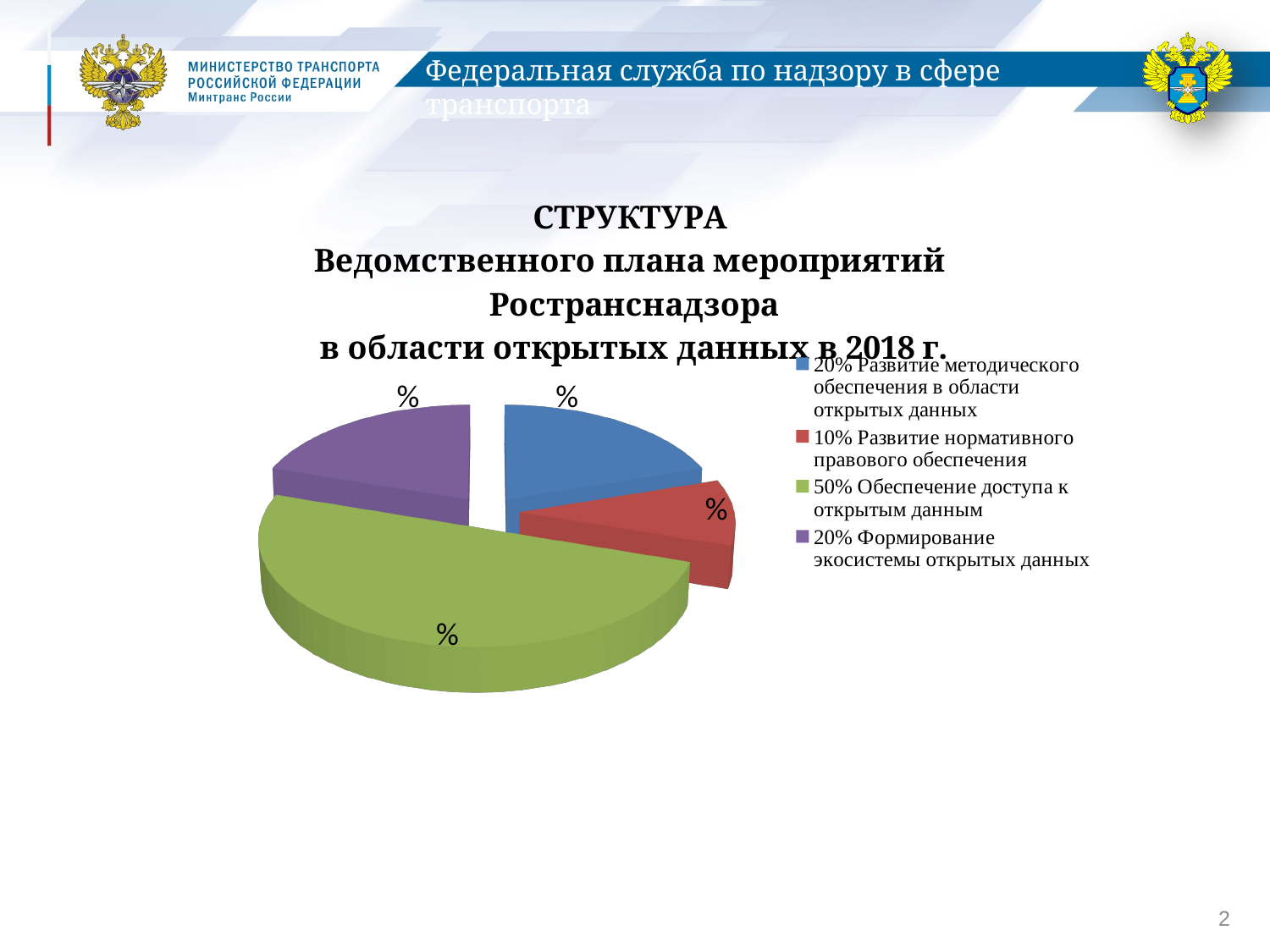
What colour is the slice for "Обеспечение доступа к открытым данным"? green What share of the pie does "Формирование экосистемы открытых данных" have? 20% What share of the pie does "Развитие нормативного правового обеспечения" have? 10% Which category has the smallest share of the pie chart? Развитие нормативного правового обеспечения Which is larger: the share for "Развитие методического обеспечения в области открытых данных" or the share for "Развитие нормативного правового обеспечения"? Развитие методического обеспечения в области открытых данных What share of the pie does "Обеспечение доступа к открытым данным" have? 50% How many slices does the pie chart have? 4 What kind of chart is shown on the slide? pie chart How many entries does the legend of the pie chart list? 4 What colour is the slice for "Развитие нормативного правового обеспечения"? red Which category has the largest share of the pie chart? Обеспечение доступа к открытым данным What is the difference between the share for "Обеспечение доступа к открытым данным" and the share for "Развитие нормативного правового обеспечения"? 40%